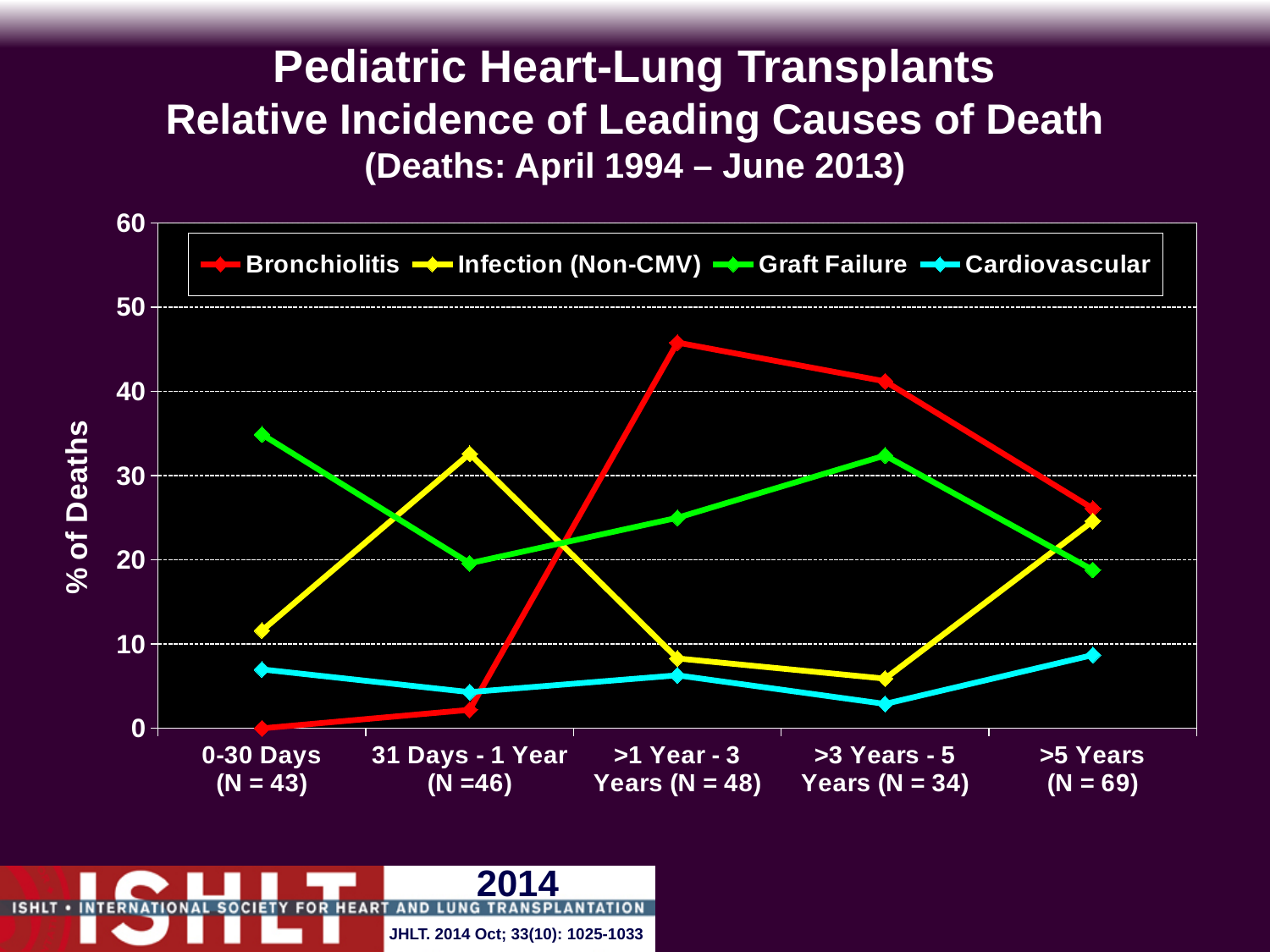
Is the value for Bronchiolitis at >1 Year - 3 Years greater or less than 40? greater In which time period is the Bronchiolitis value highest? >1 Year - 3 Years Is the value for Graft Failure at 0-30 Days greater or less than 30? greater How many time-period categories are shown on the x axis? 5 Is the value for Cardiovascular at >3 Years - 5 Years greater or less than 10? less Which cause of death has the lowest value at 0-30 Days? Bronchiolitis At 31 Days - 1 Year, which is larger: Infection (Non-CMV) or Graft Failure? Infection (Non-CMV) What kind of chart is shown on the slide? line chart Which cause of death has the highest value at 0-30 Days? Graft Failure Does the Bronchiolitis line rise or fall from >1 Year - 3 Years to >5 Years? fall What is the value for Bronchiolitis at 0-30 Days? 0 How many series does the legend list? 4